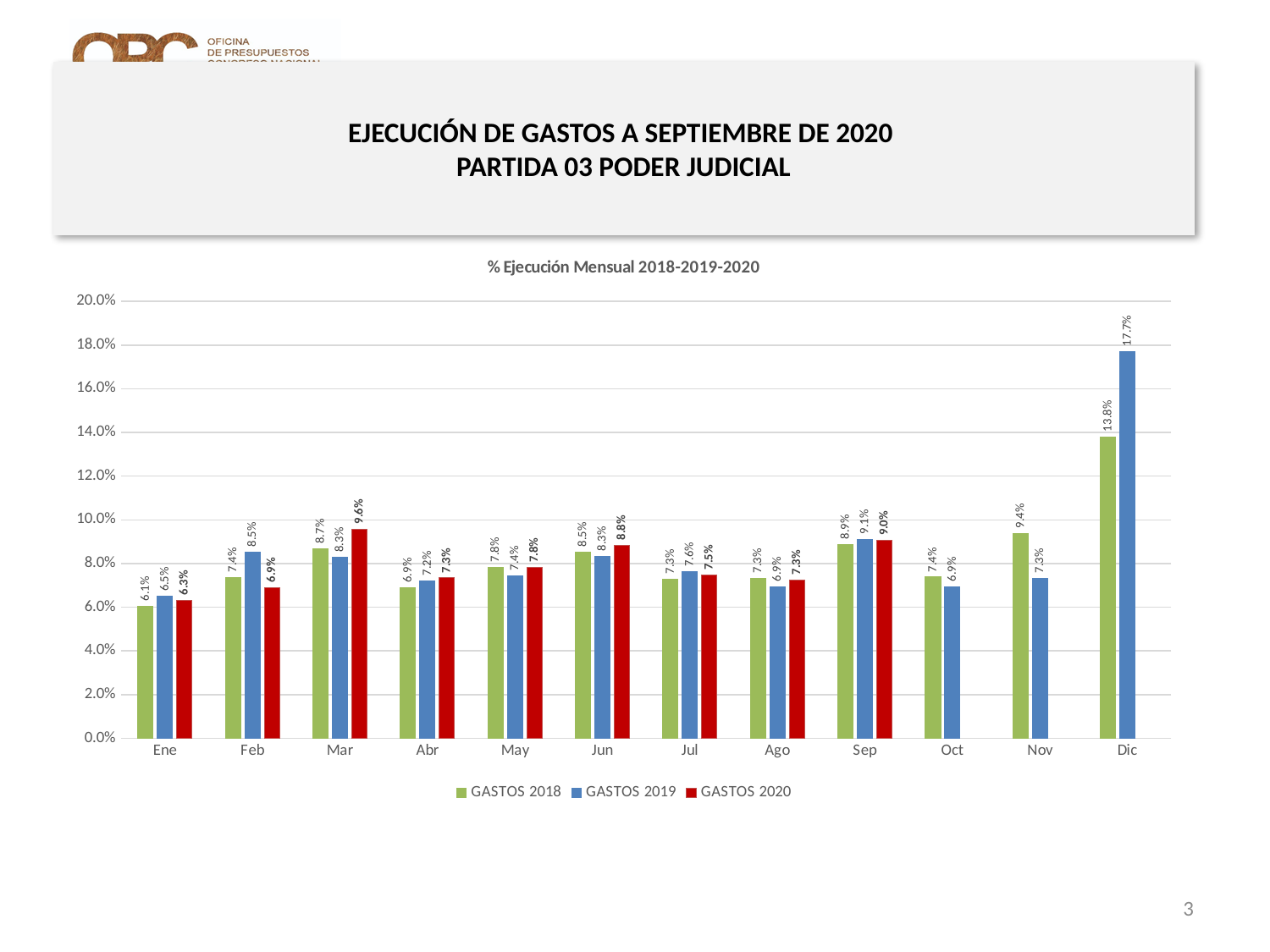
What is the value for GASTOS 2018 in Nov? 9.4% In which month is the GASTOS 2018 value lowest? Ene How many months are shown on the x axis? 12 How many series does the legend list? 3 Which is larger in Feb, GASTOS 2019 or GASTOS 2020? GASTOS 2019 What kind of chart is shown on the slide? Bar chart In which month is the GASTOS 2018 value highest? Dic What is the value for GASTOS 2020 in Ene? 6.3% What is the title of the chart? % Ejecución Mensual 2018-2019-2020 What is the value for GASTOS 2020 in Mar? 9.6% What is the difference between GASTOS 2019 and GASTOS 2018 in Dic? 3.9% What is the value for GASTOS 2019 in Dic? 17.7%